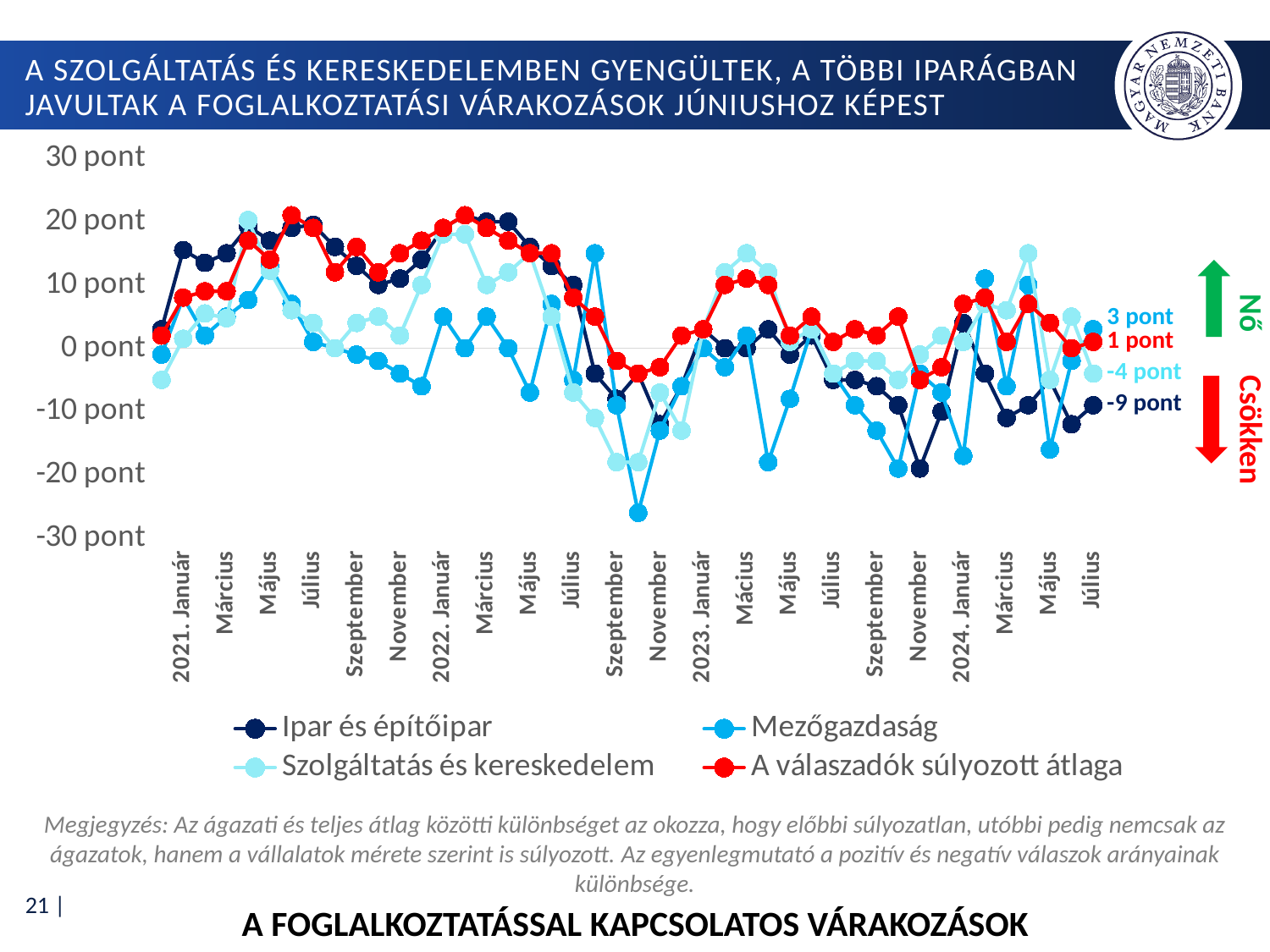
What is the latest value shown for Szolgáltatás és kereskedelem? -4 pont What is the latest value shown for A válaszadók súlyozott átlaga? 1 pont At the last data point, which is larger: A válaszadók súlyozott átlaga or Szolgáltatás és kereskedelem? A válaszadók súlyozott átlaga Which series has the highest value at the last data point (2024 July)? Mezőgazdaság Is the value for Mezőgazdaság in November 2022 greater or less than -20 pont? greater How many series does the legend list? 4 What is the difference between the latest values of Mezőgazdaság and Ipar és építőipar? 12 pont What kind of chart is shown on the slide? line chart Which series has the lowest value at the last data point (2024 July)? Ipar és építőipar What is the latest (2024 July) value shown for Mezőgazdaság? 3 pont What is the latest value shown for Ipar és építőipar? -9 pont Which series is drawn in red? A válaszadók súlyozott átlaga